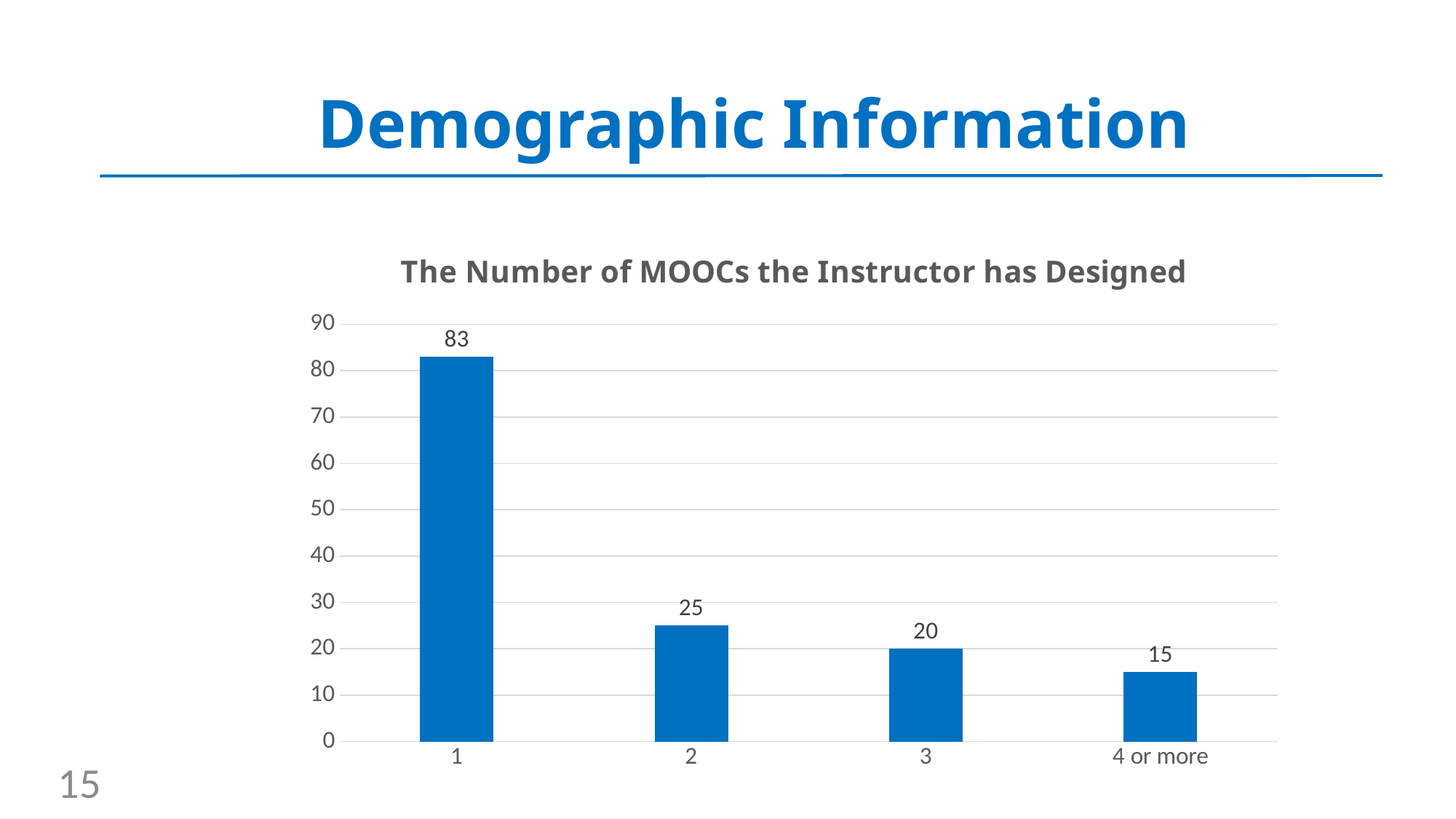
What is the value for the category "4 or more"? 15 What is the difference between the values for categories "1" and "2"? 58 Is the value for "1" greater or less than 80? greater What kind of chart is shown on the slide? bar chart Which is larger, the value for "2" or the value for "3"? 2 Which category has the highest value? 1 What is the value for the category "1"? 83 What is the difference between the values for categories "3" and "4 or more"? 5 What is the title of the chart? The Number of MOOCs the Instructor has Designed How many categories are shown on the x axis? 4 What is the value for the category "3"? 20 Which category has the lowest value? 4 or more